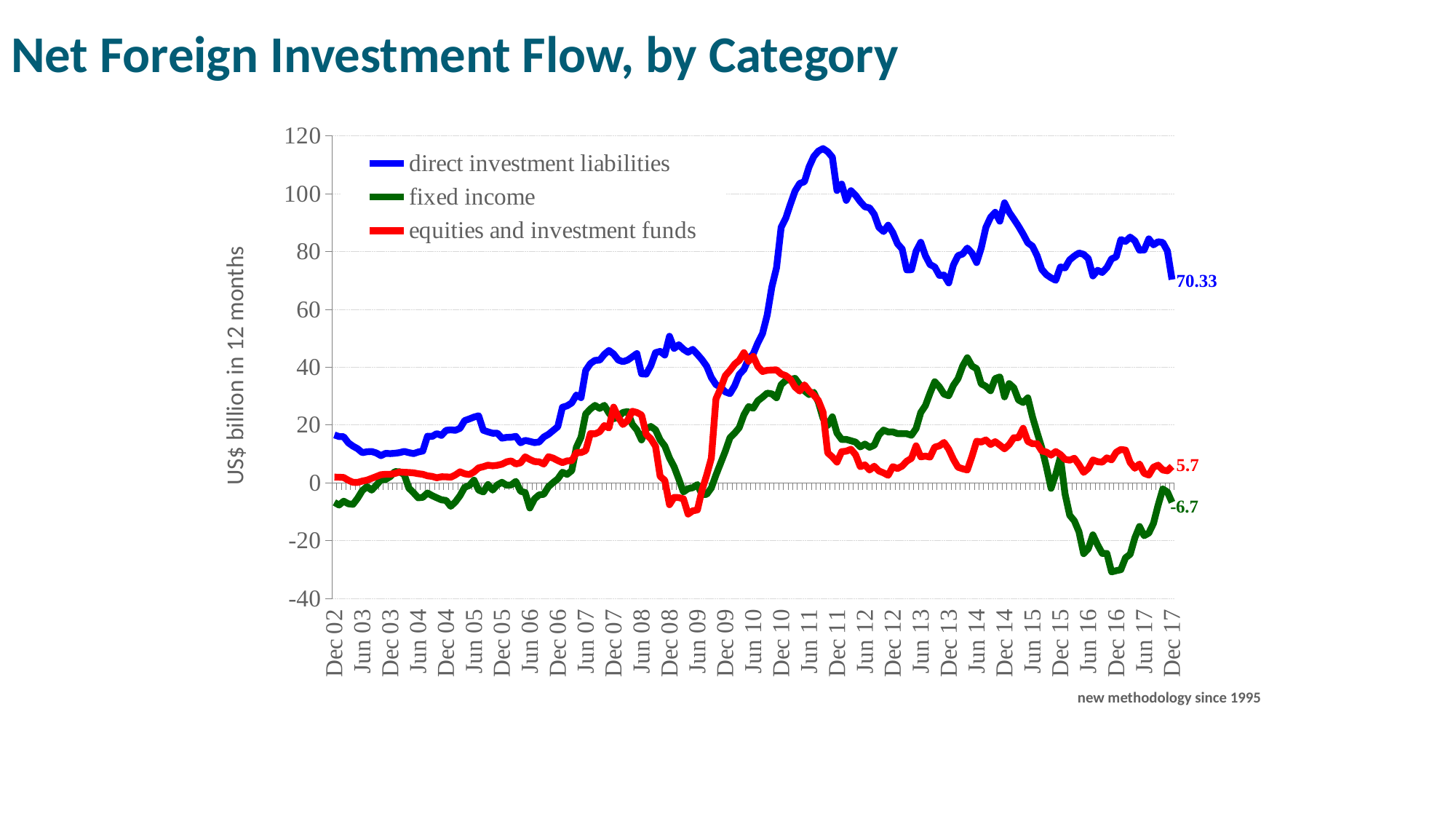
Which series has the highest value at Dec 17? direct investment liabilities What is the value of equities and investment funds at Dec 17? 5.7 Which series has the lowest value at Dec 17? fixed income How many series does the legend list? 3 What is the value of fixed income at Dec 17? -6.7 What is the value of direct investment liabilities at Dec 17? 70.33 Is the value for direct investment liabilities at Jun 11 greater or less than 100? greater What kind of chart is shown on the slide? line chart What is the difference between direct investment liabilities and equities and investment funds at Dec 17? 64.63 Does the direct investment liabilities line rise or fall overall from Jun 11 to Dec 17? fall Is the value for fixed income at Dec 16 greater or less than -20? less What is the label on the vertical axis? US$ billion in 12 months